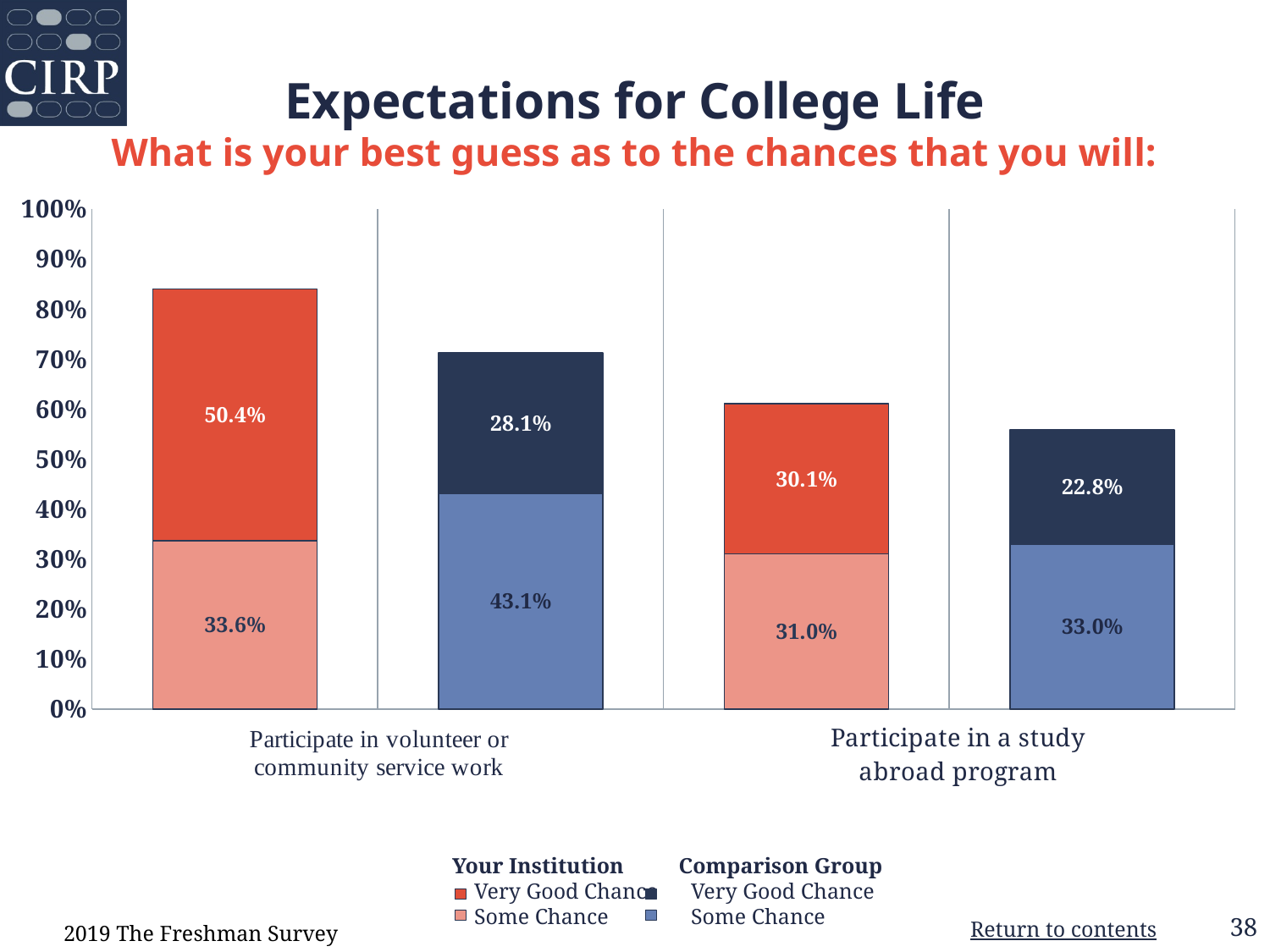
What is the difference between the Your Institution and Comparison Group Very Good Chance values for participating in volunteer or community service work? 22.3% What kind of chart is shown on the slide? Stacked bar chart Which Very Good Chance value is the lowest on the chart? 22.8% (Comparison Group, study abroad program) What percentage of the Comparison Group said there is a Very Good Chance they will participate in volunteer or community service work? 28.1% Which is larger: the Some Chance value for Your Institution or for the Comparison Group for participating in a study abroad program? Comparison Group How many entries does the legend list? 4 Is the total of the Comparison Group bar for volunteer or community service work greater or less than 70%? greater What is the total height of the Comparison Group stacked bar for participating in a study abroad program? 55.8% What percentage of the Comparison Group said there is Some Chance they will participate in a study abroad program? 33.0% What is the total height of the Your Institution stacked bar for participating in volunteer or community service work? 84.0% What colour represents Very Good Chance for Your Institution? Red What percentage of Your Institution respondents said there is a Very Good Chance they will participate in volunteer or community service work? 50.4%